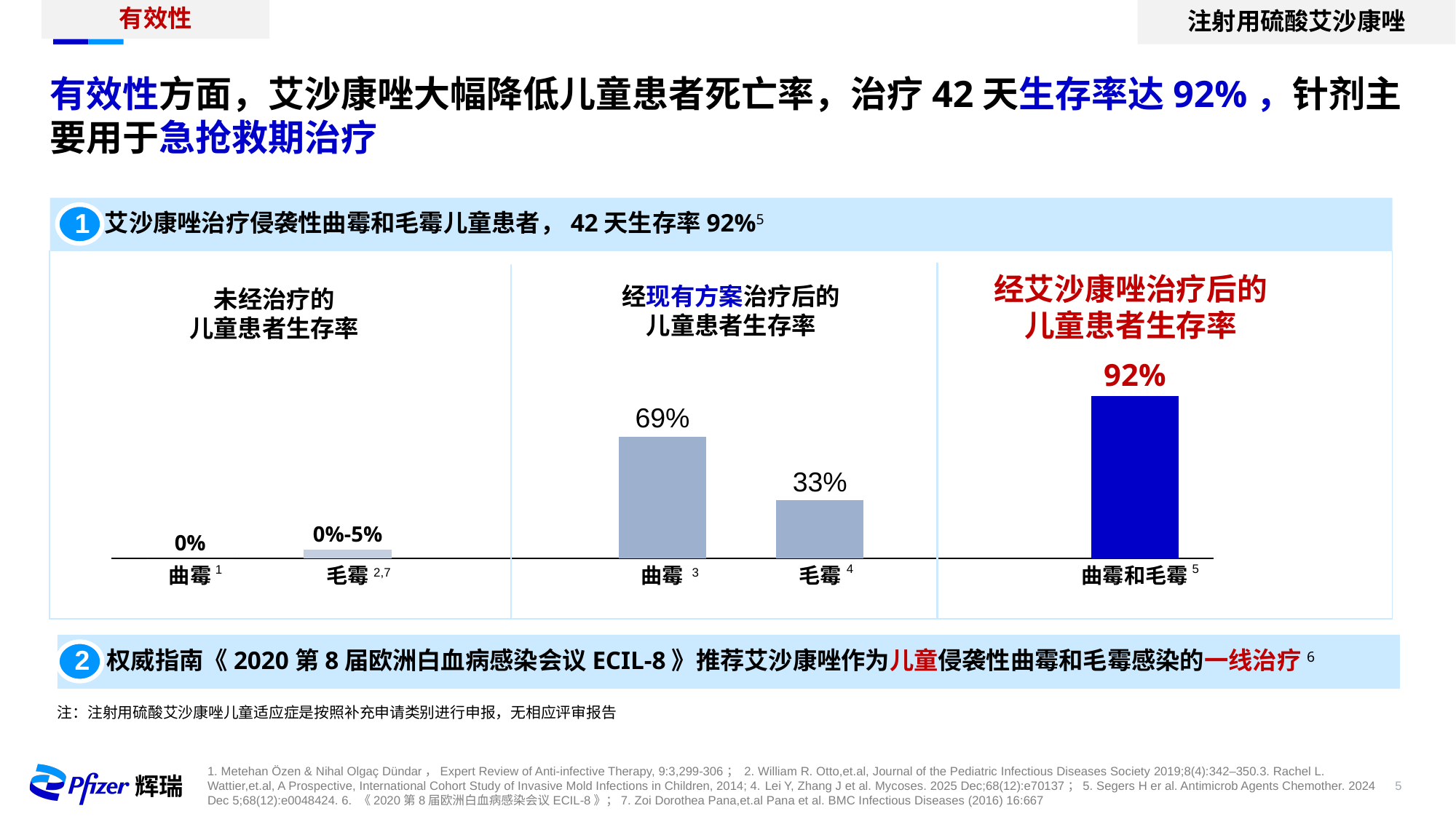
What is the difference between the isavuconazole survival rate (92%) and the existing-treatment survival rate for 曲霉 (69%)? 23% In the 经现有方案治疗后的儿童患者生存率 panel, what is the survival rate for 曲霉? 69% What is the 42-day survival rate shown for children treated with isavuconazole (经艾沙康唑治疗后的儿童患者生存率, 曲霉和毛霉)? 92% In the 未经治疗的儿童患者生存率 panel, what survival rate is shown for 毛霉? 0%-5% In the 经现有方案治疗后的儿童患者生存率 panel, what is the survival rate for 毛霉? 33% How many bars (categories) are shown across the three panels of the chart? 5 Which bar in the chart has the highest survival rate? 曲霉和毛霉 (经艾沙康唑治疗后) What is the difference between the existing-treatment survival rates for 曲霉 and 毛霉? 36% In the 未经治疗的儿童患者生存率 panel, what survival rate is shown for 曲霉? 0% Which is larger: the existing-treatment survival rate for 曲霉 or for 毛霉? 曲霉 What colour is the bar for the isavuconazole-treated group (曲霉和毛霉)? Dark blue What type of chart is used to show the survival rates? Bar chart